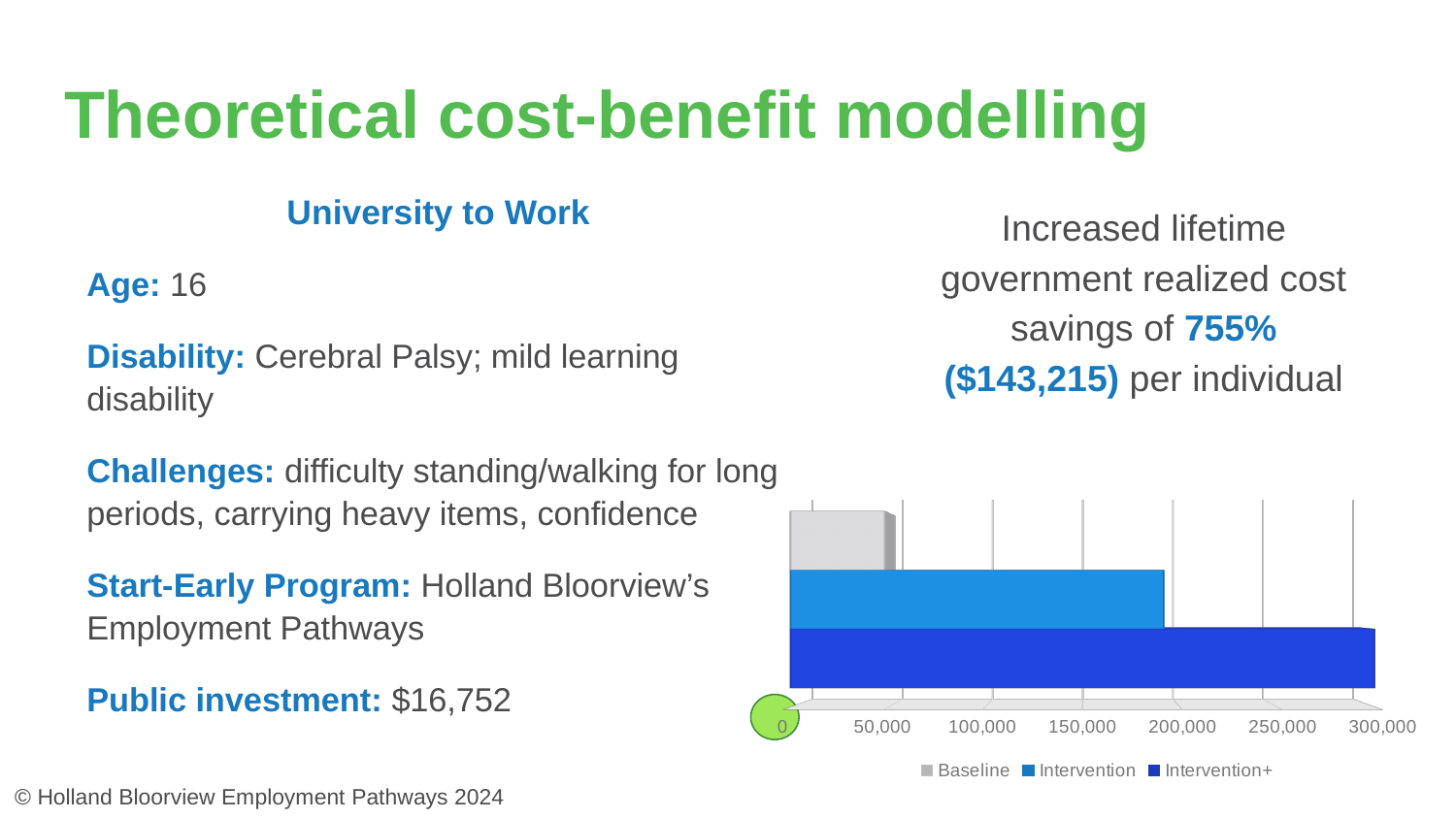
Which is larger, the value for Intervention+ or the value for Intervention? Intervention+ Which is larger, the value for Intervention or the value for Baseline? Intervention What are the three entries in the chart legend? Baseline, Intervention, Intervention+ Is the value for Intervention greater or less than 250,000? less Is the value for Intervention+ greater or less than 250,000? greater What colour is the Baseline bar in the chart? gray Which series has the shortest bar in the chart? Baseline Which series has the longest bar in the chart? Intervention+ How many series does the chart legend list? 3 What kind of chart is shown on the slide? bar chart Is the value for Baseline greater or less than 100,000? less